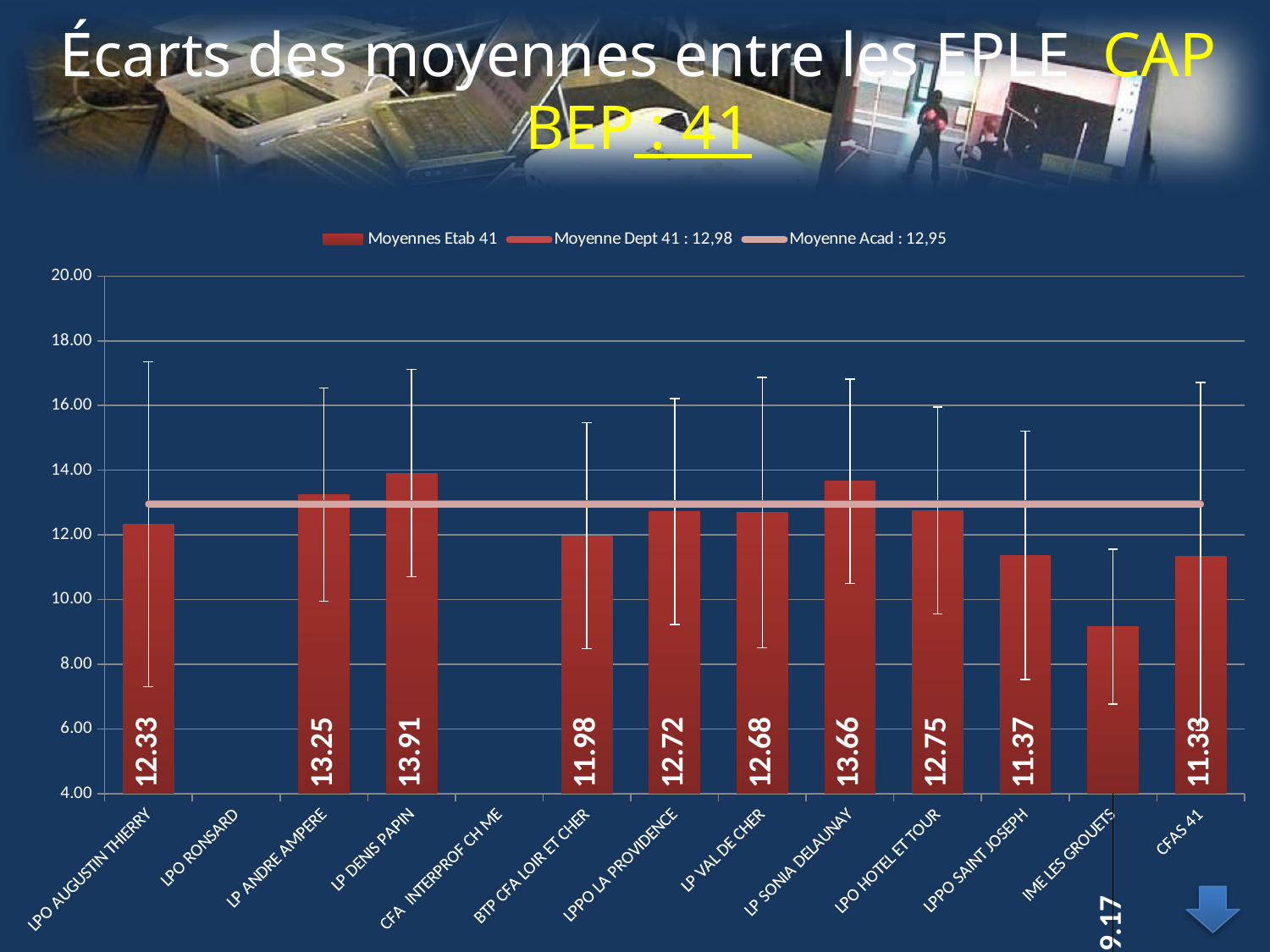
What is the value for LPO AUGUSTIN THIERRY? 12.33 Which is larger, the value for LP ANDRE AMPERE or the value for LP SONIA DELAUNAY? LP SONIA DELAUNAY What is the value for LPPO SAINT JOSEPH? 11.37 Which establishment has the highest bar? LP DENIS PAPIN What is the difference between the values for LP SONIA DELAUNAY and LPO HOTEL ET TOUR? 0.91 Is the value for LPPO SAINT JOSEPH greater or less than 12.00? less Which establishment has the lowest bar? IME LES GROUETS What kind of chart is shown on the slide? combination bar and line chart According to the legend, what is the value of Moyenne Dept 41? 12,98 What is the value for LP DENIS PAPIN? 13.91 What is the difference between the values for LP DENIS PAPIN and BTP CFA LOIR ET CHER? 1.93 How many series does the legend list? 3